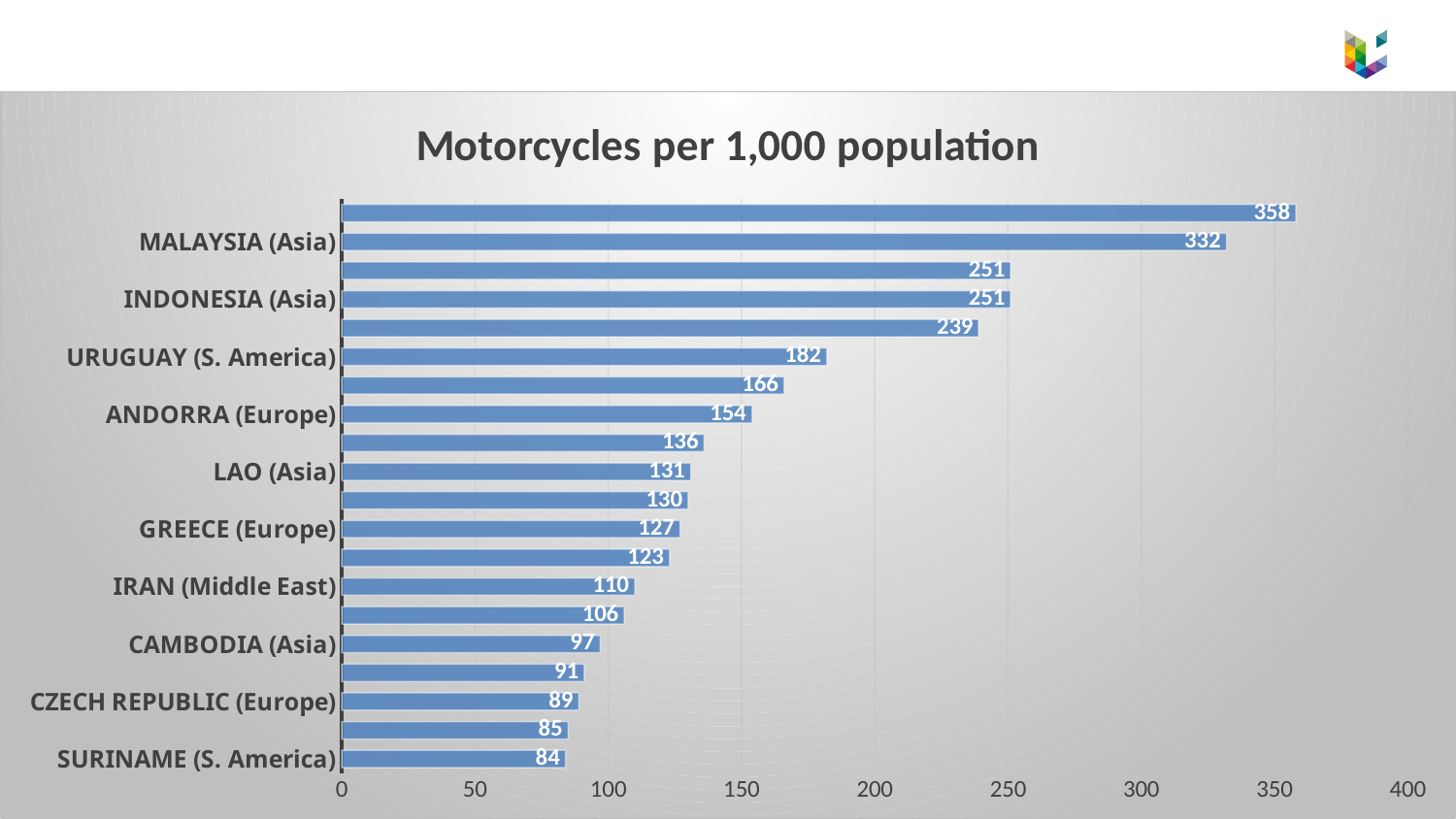
What is the value for CZECH REPUBLIC (Europe)? 89 Which labelled category has the lowest value? SURINAME (S. America) Which is larger, the value for ANDORRA (Europe) or the value for IRAN (Middle East)? ANDORRA (Europe) What kind of chart is shown on the slide? Bar chart What is the value for INDONESIA (Asia)? 251 What is the difference between the values for MALAYSIA (Asia) and INDONESIA (Asia)? 81 What is the value for URUGUAY (S. America)? 182 What is the title of the chart? Motorcycles per 1,000 population What is the highest value shown on the chart? 358 What is the value for MALAYSIA (Asia)? 332 What is the value for GREECE (Europe)? 127 How many bars are plotted on the chart? 20